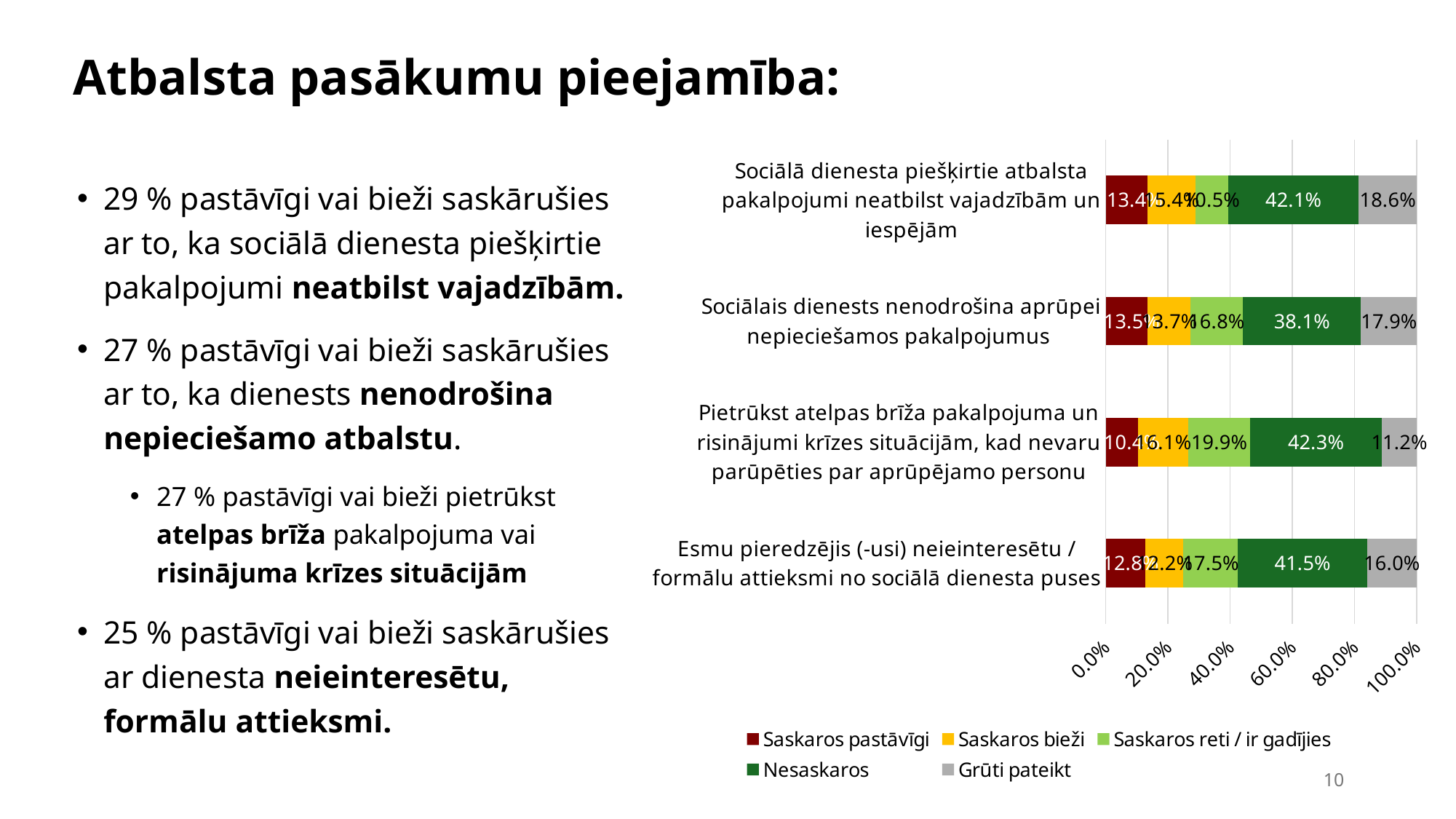
How many series does the chart legend list? 5 What is the 'Nesaskaros' value for 'Sociālais dienests nenodrošina aprūpei nepieciešamos pakalpojumus'? 38.1% How many categories (statements) are plotted in the chart? 4 What type of chart is shown on the slide? Stacked horizontal bar chart Which statement has the lowest 'Nesaskaros' value? Sociālais dienests nenodrošina aprūpei nepieciešamos pakalpojumus What is the 'Grūti pateikt' value for 'Sociālā dienesta piešķirtie atbalsta pakalpojumi neatbilst vajadzībām un iespējām'? 18.6% What is the 'Nesaskaros' value for 'Esmu pieredzējis (-usi) neieinteresētu / formālu attieksmi no sociālā dienesta puses'? 41.5% What colour represents the 'Nesaskaros' series in the chart? Dark green What is the 'Grūti pateikt' value for 'Pietrūkst atelpas brīža pakalpojuma un risinājumi krīzes situācijām, kad nevaru parūpēties par aprūpējamo personu'? 11.2% What is the difference in percentage points between the 'Grūti pateikt' values for 'Sociālā dienesta piešķirtie atbalsta pakalpojumi neatbilst vajadzībām un iespējām' and 'Pietrūkst atelpas brīža pakalpojuma un risinājumi krīzes situācijām, kad nevaru parūpēties par aprūpējamo personu'? 7.4 Which has the larger 'Grūti pateikt' value: 'Pietrūkst atelpas brīža pakalpojuma...' or 'Esmu pieredzējis (-usi) neieinteresētu / formālu attieksmi no sociālā dienesta puses'? Esmu pieredzējis (-usi) neieinteresētu / formālu attieksmi no sociālā dienesta puses Which statement has the lowest 'Grūti pateikt' value? Pietrūkst atelpas brīža pakalpojuma un risinājumi krīzes situācijām, kad nevaru parūpēties par aprūpējamo personu